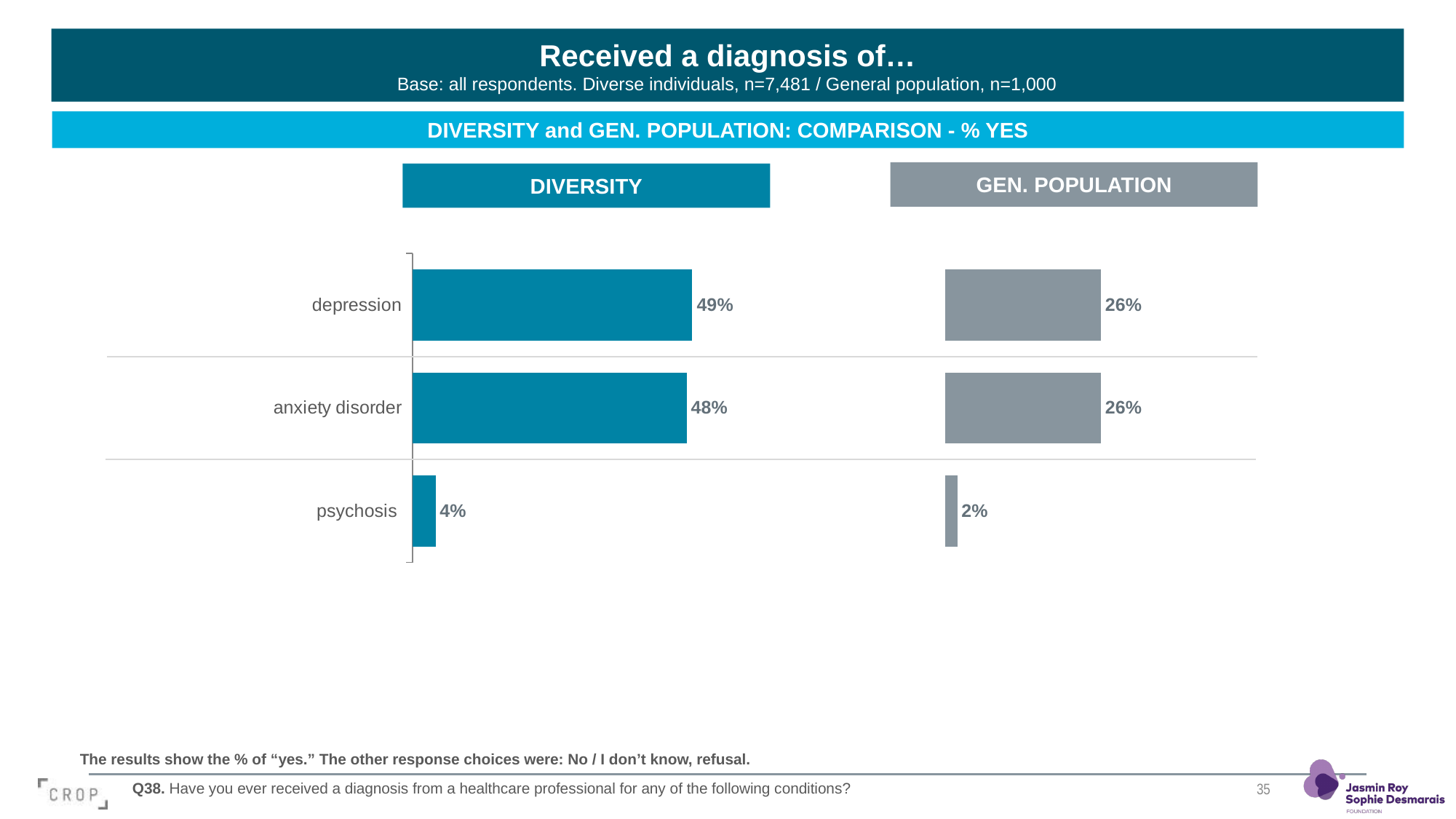
How many conditions are shown in the chart? 3 What is the Gen. Population value for psychosis? 2% Which is larger for anxiety disorder: the Diversity value or the Gen. Population value? Diversity What percentage of the Diversity group received a diagnosis of depression? 49% What are the two groups compared in the chart? Diversity and Gen. Population What type of chart is shown on the slide? bar chart Which condition has the lowest value in the Gen. Population group? psychosis What is the difference between the Diversity values for depression and anxiety disorder? 1 percentage point What is the difference between the Diversity and Gen. Population values for depression? 23 percentage points Which condition has the highest value in the Diversity group? depression What is the Diversity value for psychosis? 4% What percentage of the General Population received a diagnosis of anxiety disorder? 26%